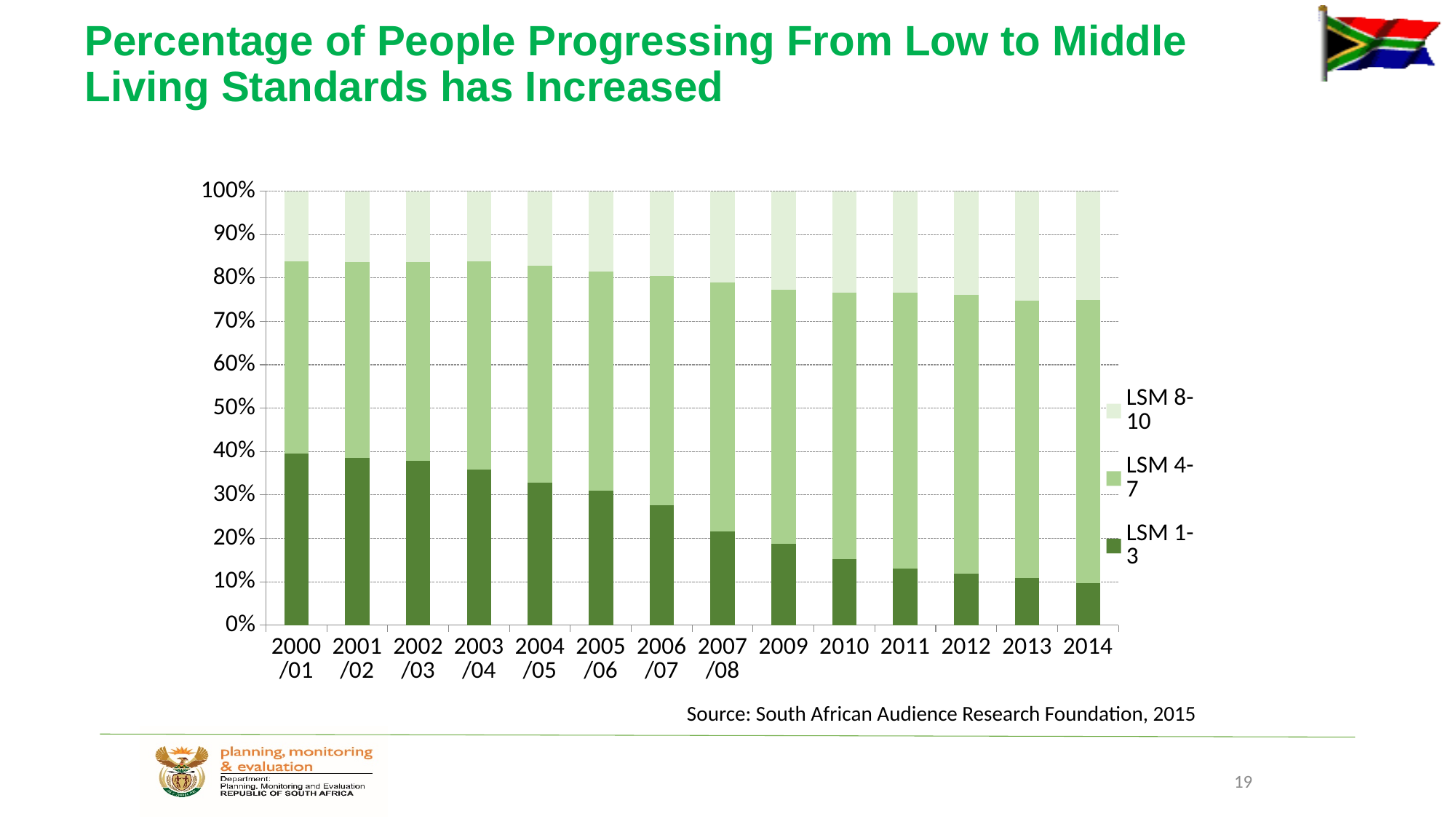
In which year is the LSM 1-3 share the lowest? 2014 Which series is shown at the bottom of each stacked bar? LSM 1-3 Is the LSM 1-3 share in 2014 greater or less than 20%? less What source is cited for the chart? South African Audience Research Foundation, 2015 How many year categories are shown on the x axis? 14 Is the LSM 1-3 share larger in 2000/01 or in 2014? 2000/01 What kind of chart is shown on the slide? Stacked bar chart In which year is the LSM 1-3 share the highest? 2000/01 How many series does the legend list? 3 What is the total of each stacked bar? 100% Is the LSM 1-3 share in 2000/01 greater or less than 30%? greater Does the LSM 1-3 share rise or fall from 2000/01 to 2014? Fall